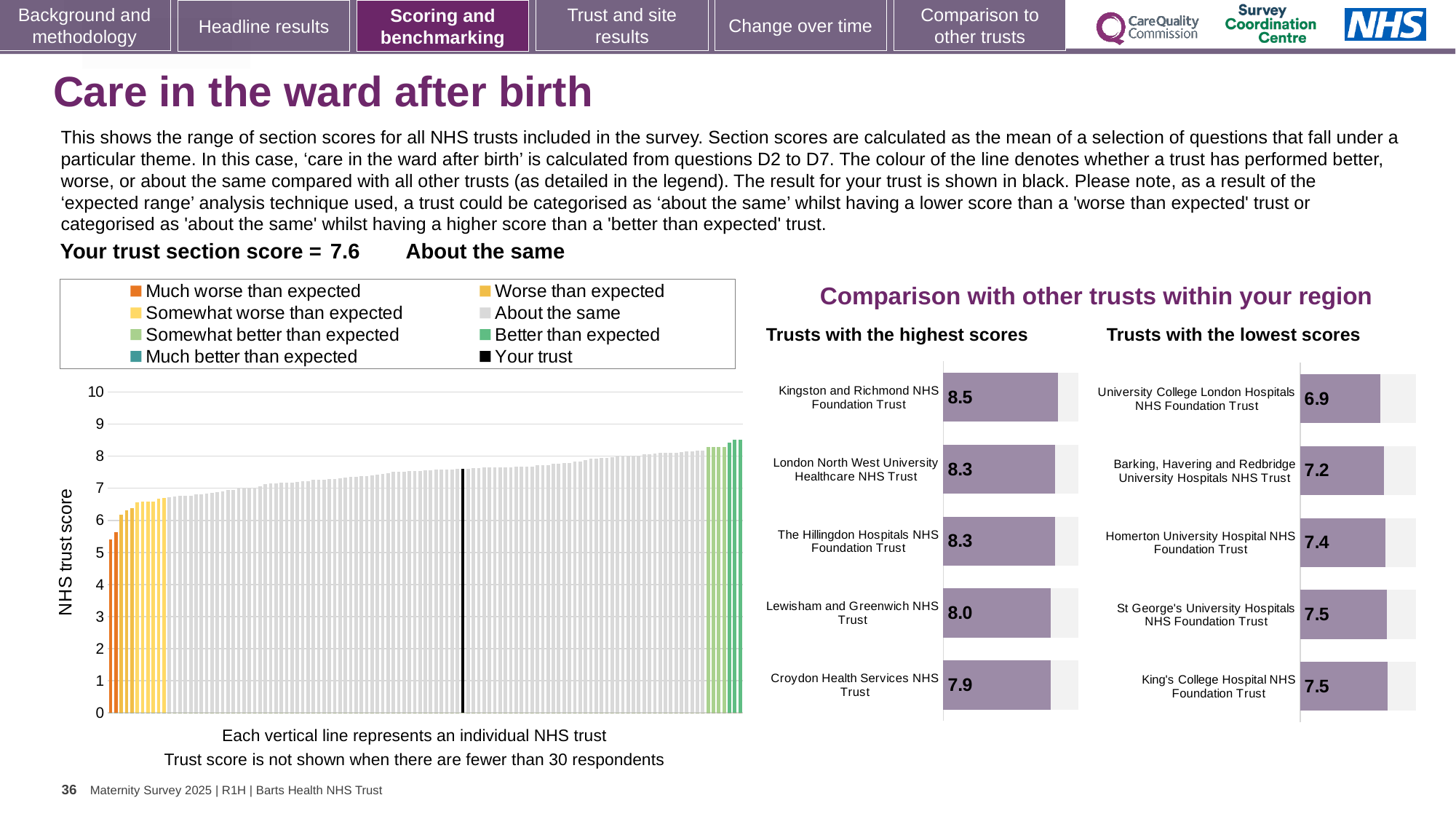
In the 'Trusts with the highest scores' chart, what is the score for Kingston and Richmond NHS Foundation Trust? 8.5 In the 'Trusts with the lowest scores' chart, what is the score for King's College Hospital NHS Foundation Trust? 7.5 In the 'Trusts with the highest scores' chart, how many trusts are shown? 5 In the 'Trusts with the lowest scores' chart, which has the larger score: Barking, Havering and Redbridge University Hospitals NHS Trust or Homerton University Hospital NHS Foundation Trust? Homerton University Hospital NHS Foundation Trust In the large chart on the left, do the trust scores rise or fall from left to right? Rise In the 'Trusts with the highest scores' chart, which trust has the highest score? Kingston and Richmond NHS Foundation Trust In the large chart on the left, is the value of the lowest bar greater or less than 6? less In the 'Trusts with the highest scores' chart, what is the difference between the scores of Kingston and Richmond NHS Foundation Trust and Croydon Health Services NHS Trust? 0.6 In the 'Trusts with the lowest scores' chart, what is the score for University College London Hospitals NHS Foundation Trust? 6.9 How many entries does the legend of the large chart on the left list? 8 What type of chart is the large chart on the left with the 'NHS trust score' axis? Bar chart In the 'Trusts with the lowest scores' chart, which trust has the lowest score? University College London Hospitals NHS Foundation Trust